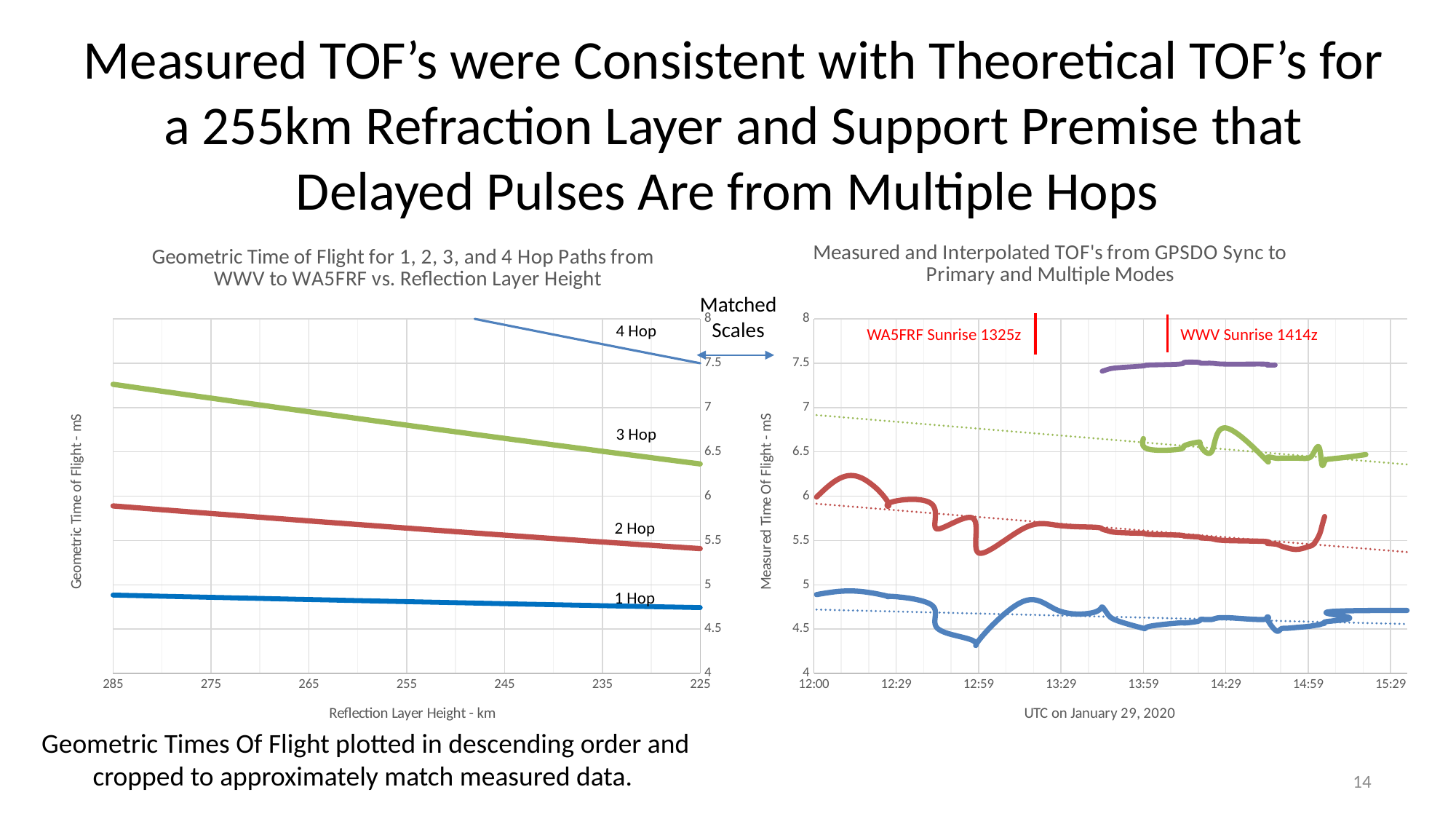
On the left chart (Geometric Time of Flight), which is larger at 245 km: the 3 Hop value or the 2 Hop value? 3 Hop On the left chart (Geometric Time of Flight), is the 1 Hop value at a reflection layer height of 285 km greater or less than 5? less On the left chart (Geometric Time of Flight), is the 3 Hop value at a reflection layer height of 285 km greater or less than 7? greater On the left chart (Geometric Time of Flight), do the hop-path lines rise or fall as you move along the x axis from 285 km to 225 km? fall On the left chart (Geometric Time of Flight), which hop path has the highest time of flight? 4 Hop On the right chart (Measured and Interpolated TOF's), is the purple line's value at 14:29 greater or less than 7? greater What is the x-axis title of the right chart (Measured and Interpolated TOF's)? UTC on January 29, 2020 What kind of chart is the left chart, 'Geometric Time of Flight for 1, 2, 3, and 4 Hop Paths from WWV to WA5FRF vs. Reflection Layer Height'? Line chart What kind of chart is the right chart, 'Measured and Interpolated TOF's from GPSDO Sync to Primary and Multiple Modes'? Line chart On the left chart (Geometric Time of Flight), which hop path has the lowest time of flight? 1 Hop How many hop-path lines are plotted on the left chart (Geometric Time of Flight vs. Reflection Layer Height)? 4